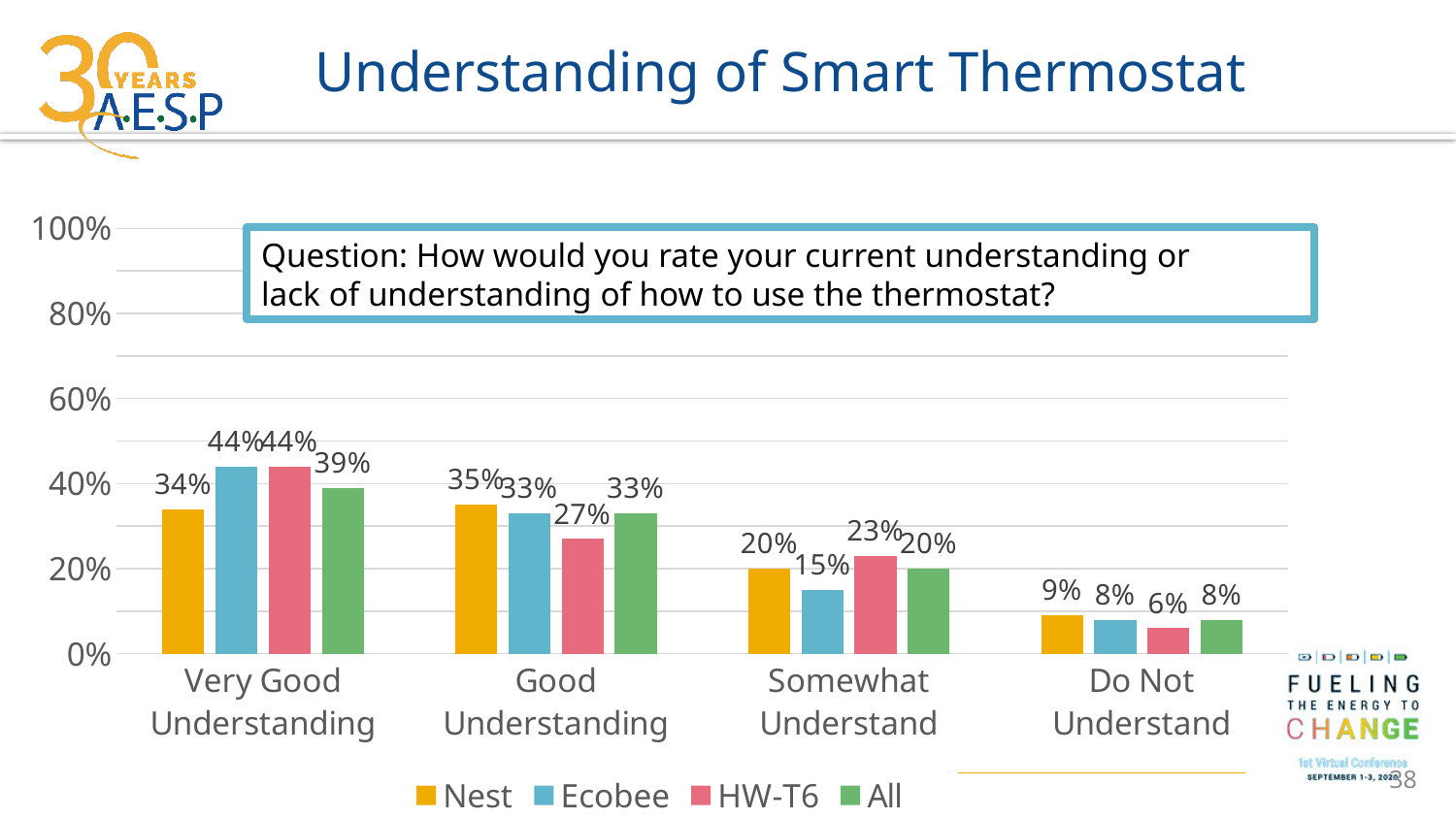
What is the value for All in the Do Not Understand category? 8% What is the value for Ecobee in the Somewhat Understand category? 15% Which series has the lowest value in the Do Not Understand category? HW-T6 What is the value for Nest in the Very Good Understanding category? 34% Which series has the highest value in the Somewhat Understand category? HW-T6 How many categories are shown on the x axis? 4 Which is larger in the Good Understanding category, the value for Nest or the value for HW-T6? Nest What is the value for HW-T6 in the Good Understanding category? 27% What kind of chart is shown on the slide? bar chart How many series does the legend list? 4 Which series is shown in green in the legend? All What is the difference between the Ecobee and Nest values in the Very Good Understanding category? 10%